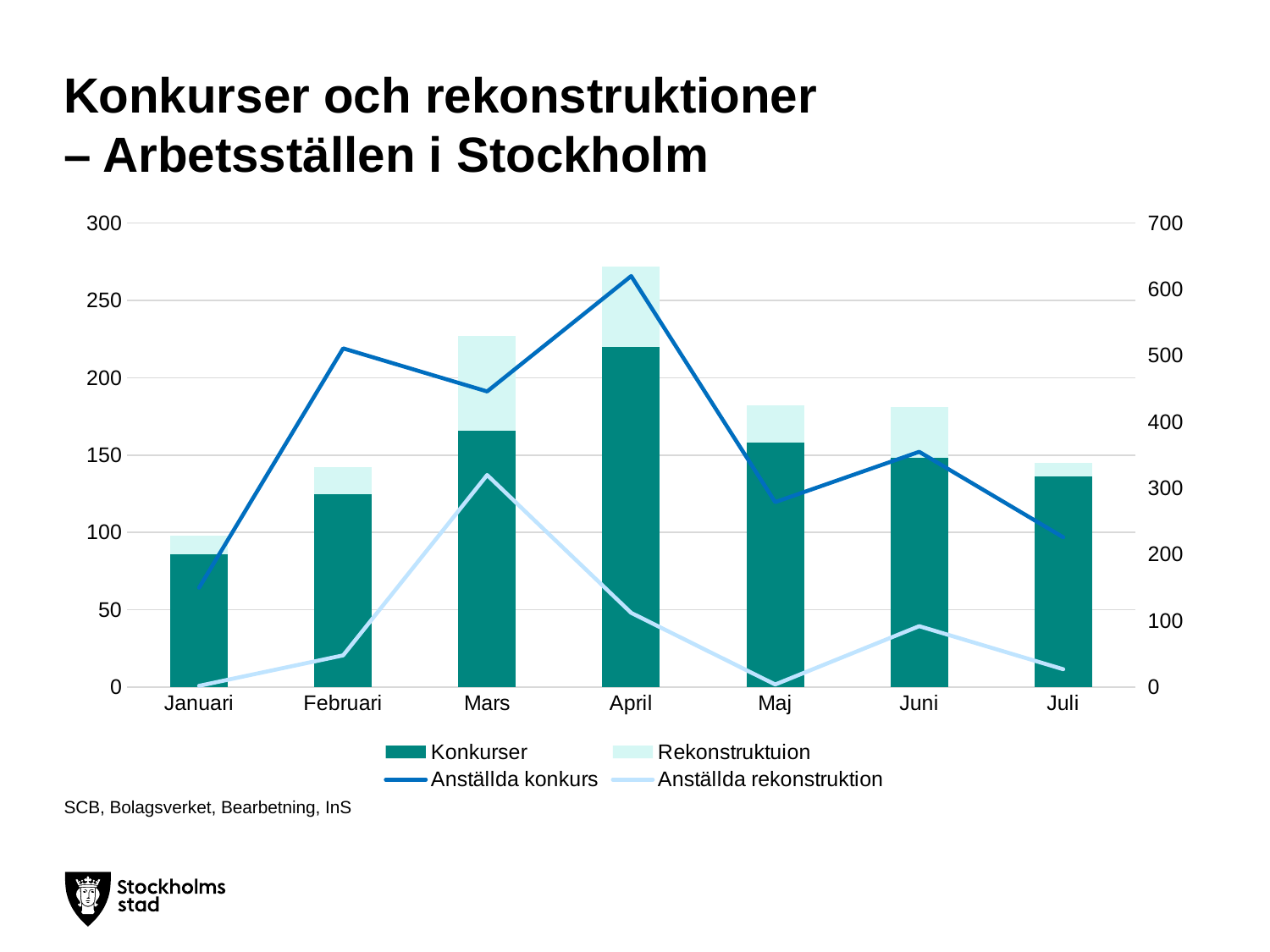
Is the Konkurser value for April greater or less than 200? greater In which month does the Anställda rekonstruktion line reach its highest point? Mars Is the Konkurser value for Januari greater or less than 100? less How many months are shown on the x axis? 7 In which month is the Konkurser bar lowest? Januari How many series does the legend list? 4 Which month has the larger Konkurser value, Februari or Maj? Maj In which month is the Konkurser bar highest? April In which month does the Anställda konkurs line reach its peak? April Is the Anställda konkurs value for Februari greater or less than 400 on the right axis? greater Do the Konkurser bars rise or fall from April to Juli? fall What kind of chart is used for the Konkurser and Rekonstruktuion series? bar chart